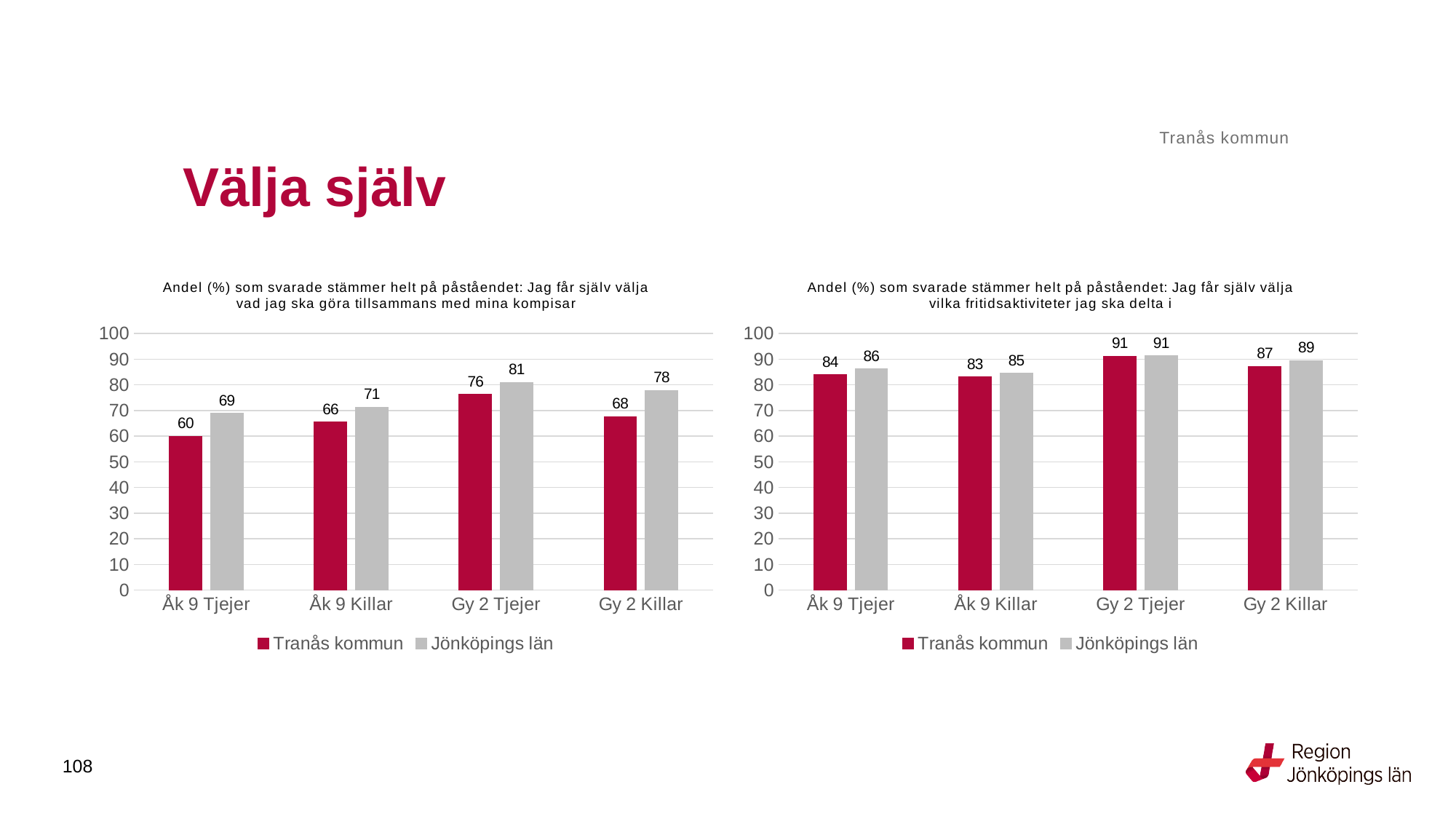
In the left chart, do the Jönköpings län values rise or fall from Åk 9 Tjejer to Gy 2 Tjejer? Rise In the left chart, which category has the highest value for Tranås kommun? Gy 2 Tjejer How many series does the legend of the right chart list? 2 In the left chart, what is the difference between Jönköpings län and Tranås kommun for Gy 2 Killar? 10 How many categories are shown on the x axis of the left chart? 4 In the right chart (about choosing leisure activities), what is the value for Jönköpings län for Gy 2 Killar? 89 In the left chart (about choosing what to do with friends), what is the value for Tranås kommun for Åk 9 Tjejer? 60 What kind of chart is the left chart? Bar chart In the right chart, is the value for Tranås kommun for Gy 2 Tjejer greater or less than 80? greater In the right chart, what is the difference between Jönköpings län and Tranås kommun for Åk 9 Tjejer? 2 In the right chart, which category has the lowest value for Tranås kommun? Åk 9 Killar In the left chart, which is larger for Åk 9 Killar: Tranås kommun or Jönköpings län? Jönköpings län